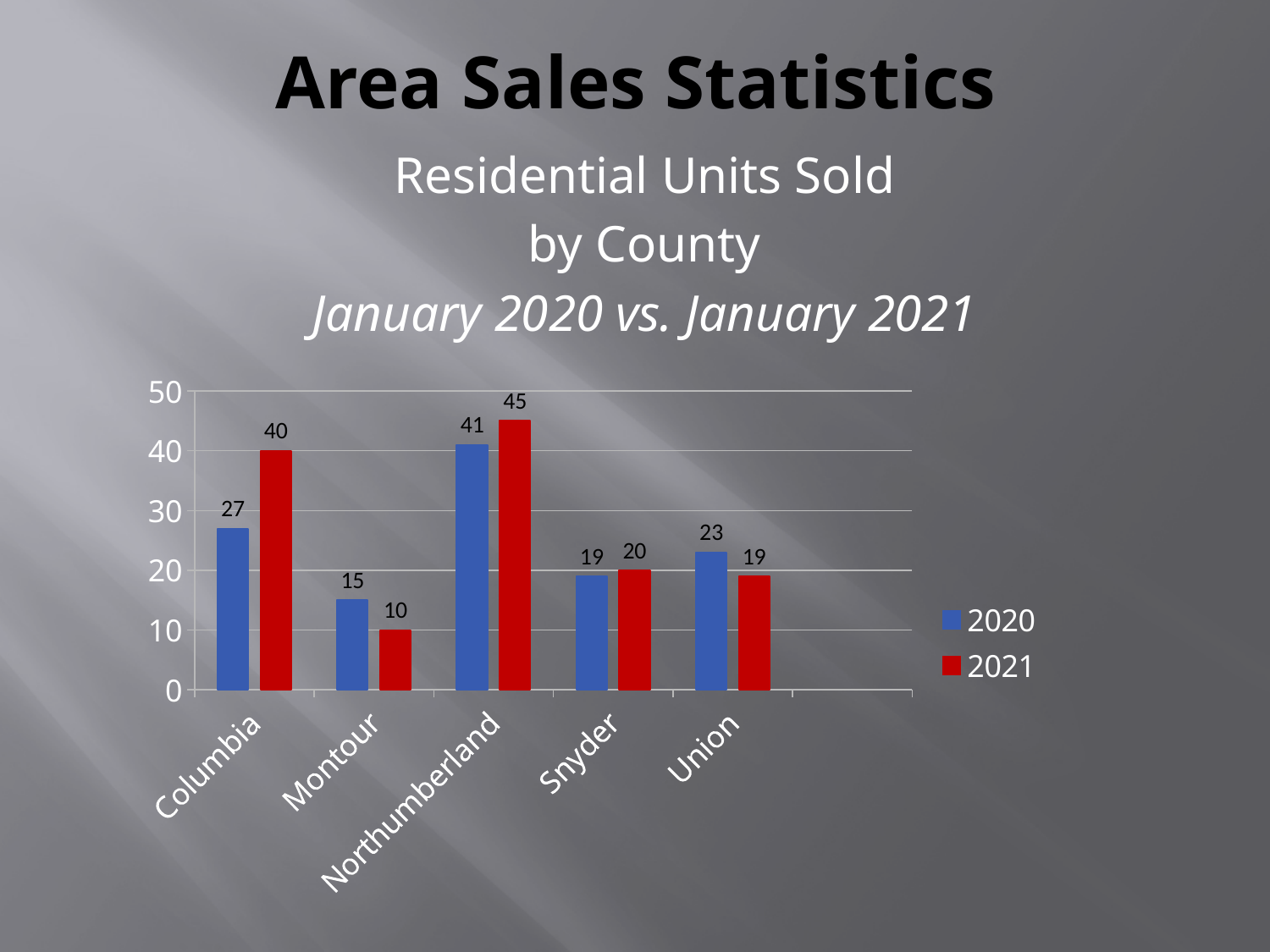
What is the difference between the 2021 and 2020 values for Columbia? 13 How many counties are shown on the x axis? 5 Which is larger for Union: the 2020 value or the 2021 value? 2020 Which county had the lowest number of units sold in 2020? Montour How many series does the legend list? 2 How many residential units were sold in Montour in 2020? 15 Which county had the highest number of units sold in 2021? Northumberland Which colour represents the 2021 series in the legend? red What kind of chart is shown on the slide? bar chart Is the 2020 value for Northumberland greater or less than 30? greater What was the number of residential units sold in Columbia in 2021? 40 What is the 2021 value for Snyder? 20